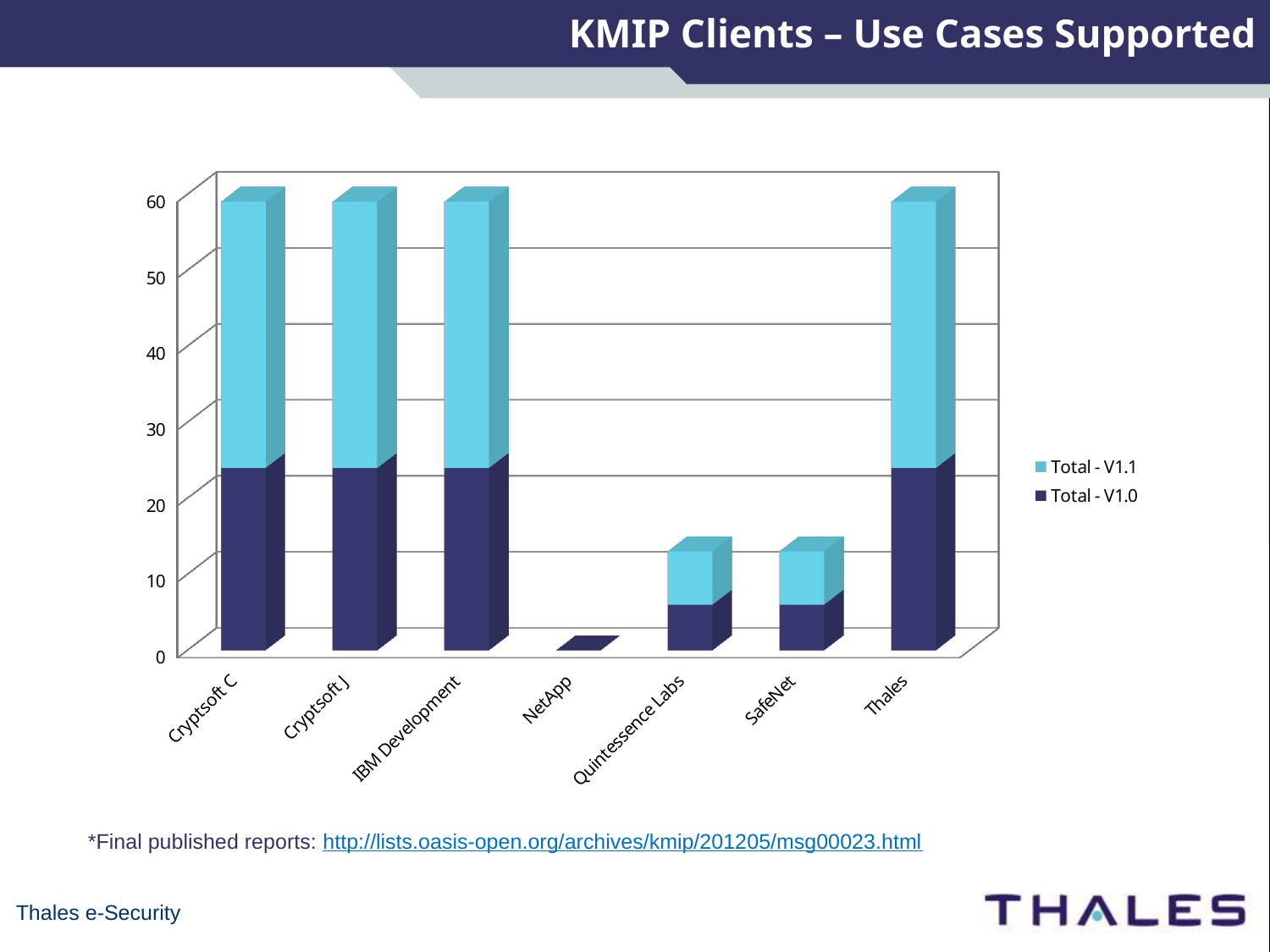
Which has the larger total bar, Thales or SafeNet? Thales What is the title of the slide containing the chart? KMIP Clients – Use Cases Supported How many series does the chart's legend list? 2 Is the total bar for Cryptsoft C greater or less than 50? greater Which client has the lowest total bar in the chart? NetApp How many clients (categories) are shown on the x axis of the chart? 7 What are the two series named in the legend? Total - V1.1 and Total - V1.0 What kind of chart is shown on the slide? Stacked bar chart Is the total bar for NetApp greater or less than 10? less Which has the larger total bar, Quintessence Labs or IBM Development? IBM Development Is the total bar for SafeNet greater or less than 30? less